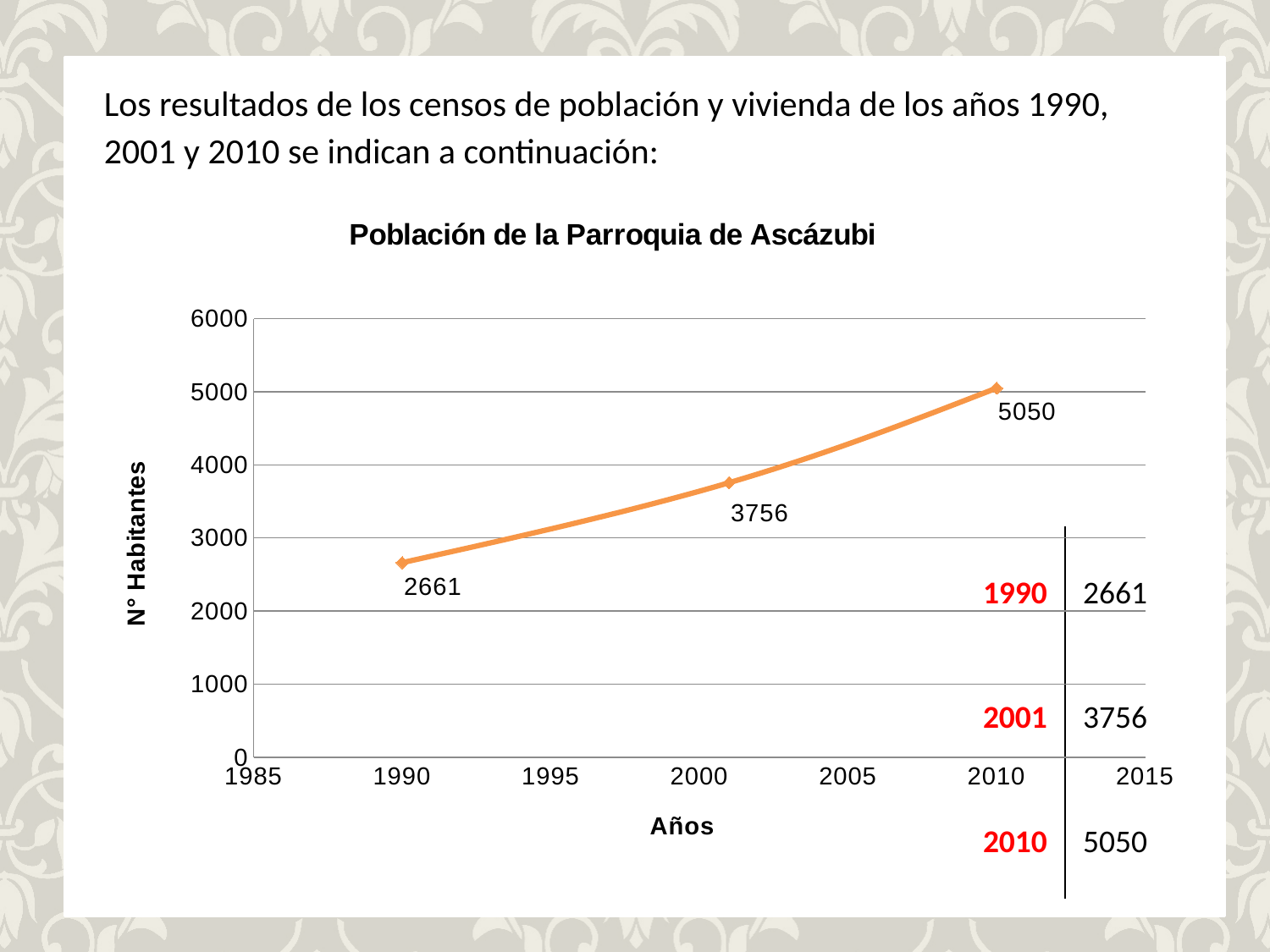
What is the population value shown for 1990? 2661 How many data points are plotted on the chart? 3 Does the population rise or fall over the years shown? rise What is the population value shown for 2010? 5050 Which is larger, the population in 2001 or in 2010? 2010 What is the difference in population between 2001 and 1990? 1095 Is the population value for 2001 greater or less than 4000? less What kind of chart is shown? line chart Which year has the lowest population? 1990 What is the population value shown for 2001? 3756 Which year has the highest population? 2010 What is the difference in population between 2010 and 1990? 2389